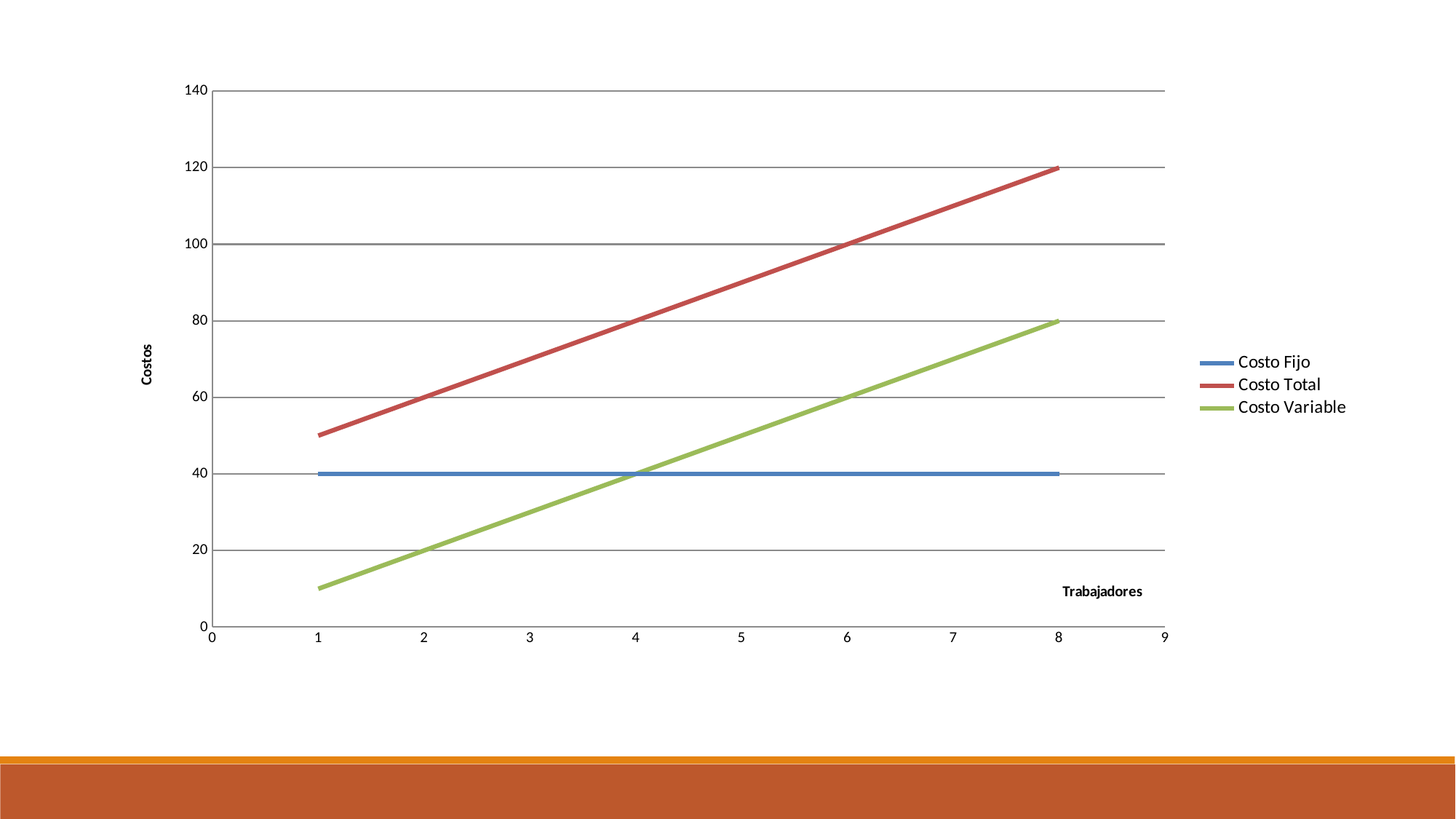
How many series does the legend list? 3 What is the value of Costo Total at 8 Trabajadores? 120 What is the value of Costo Variable at 4 Trabajadores? 40 What is the label of the vertical axis? Costos What kind of chart is shown on the slide? line chart What is the difference between Costo Total and Costo Variable at 8 Trabajadores? 40 Is the value of Costo Total at 1 Trabajadores greater or less than 40? greater Which series has the highest value at 8 Trabajadores? Costo Total Which series has the lowest value at 1 Trabajadores? Costo Variable What is the value of Costo Fijo at 4 Trabajadores? 40 What is the value of Costo Variable at 8 Trabajadores? 80 Does Costo Variable rise or fall as Trabajadores increases? rise